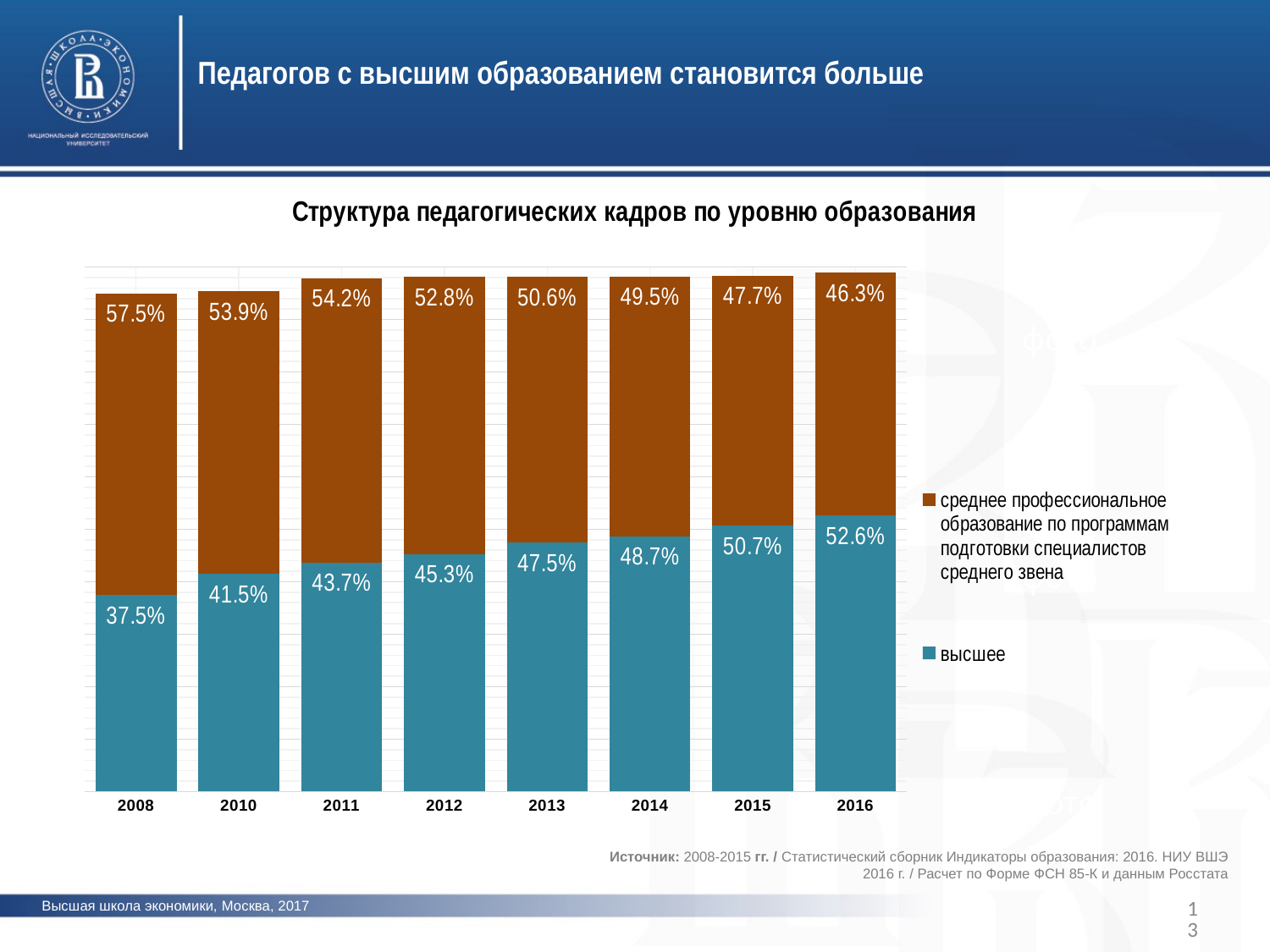
Does the share of "высшее" rise or fall from 2008 to 2016? rise Which is larger in 2015: "высшее" or "среднее профессиональное образование"? высшее What is the difference between the "высшее" values in 2016 and 2008? 15.1% How many years are shown on the x axis? 8 How many series does the legend list? 2 What type of chart is shown on the slide? stacked bar chart What is the value for "высшее" in 2013? 47.5% In which year is the share of "среднее профессиональное образование" the lowest? 2016 What is the value for "высшее" in 2008? 37.5% What is the title of the chart? Структура педагогических кадров по уровню образования In which year is the share of "высшее" the highest? 2016 What is the value for "среднее профессиональное образование по программам подготовки специалистов среднего звена" in 2016? 46.3%